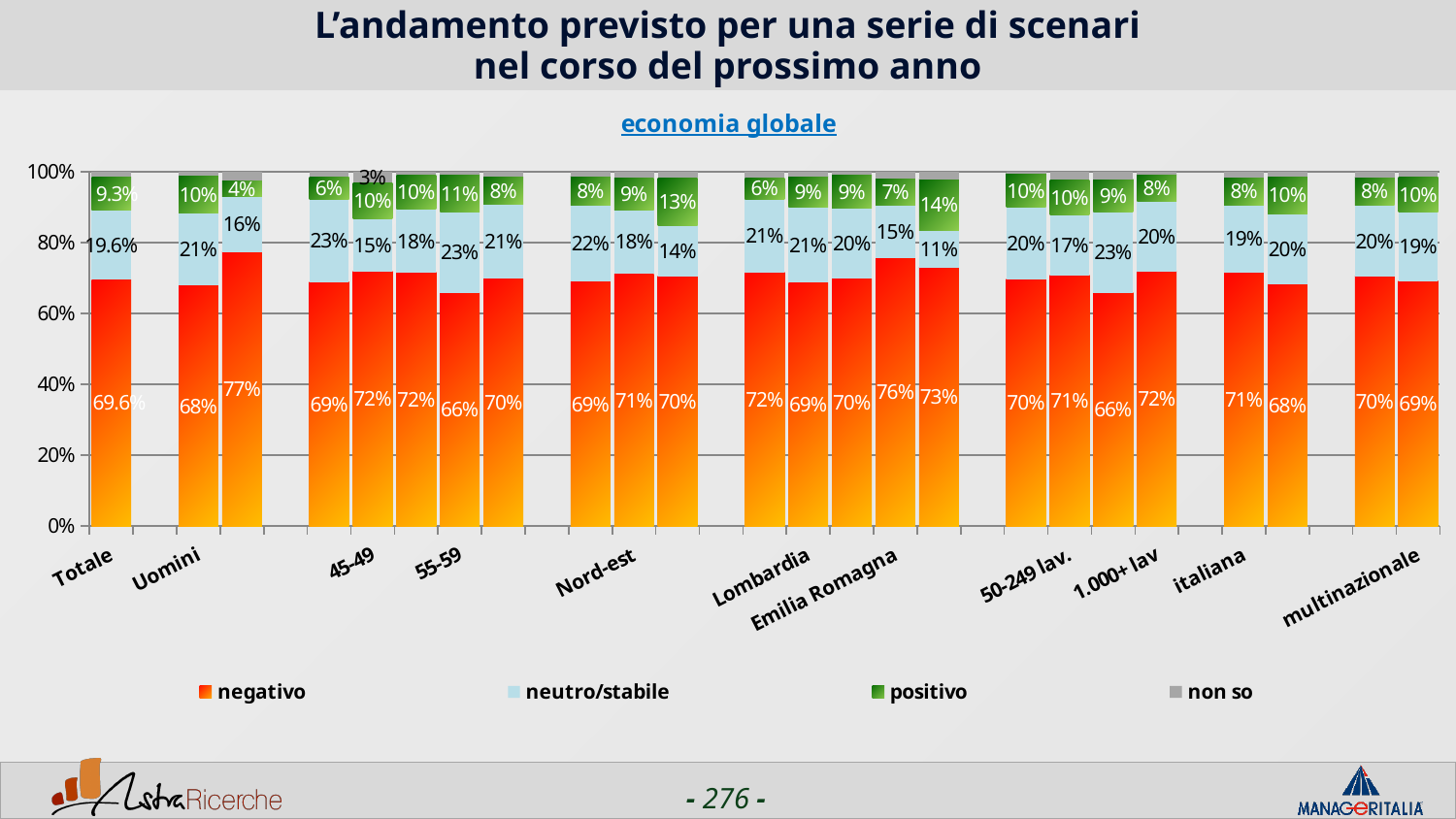
What kind of chart is shown on the slide? Stacked bar chart What is the 'positivo' value for Totale? 9.3% Is the 'negativo' value for Totale greater or less than 60%? greater How many series does the legend list? 4 What is the 'negativo' value for Totale? 69.6% Which has the larger 'negativo' value, Totale or Uomini? Totale What is the 'neutro/stabile' value for Uomini? 21% What is the 'negativo' value for Emilia Romagna? 76% What is the 'negativo' value for Uomini? 68% What is the subtitle shown above the chart? economia globale What is the 'neutro/stabile' value for Totale? 19.6% What is the difference between the 'negativo' value for Totale and the 'negativo' value for Uomini? 1.6 percentage points